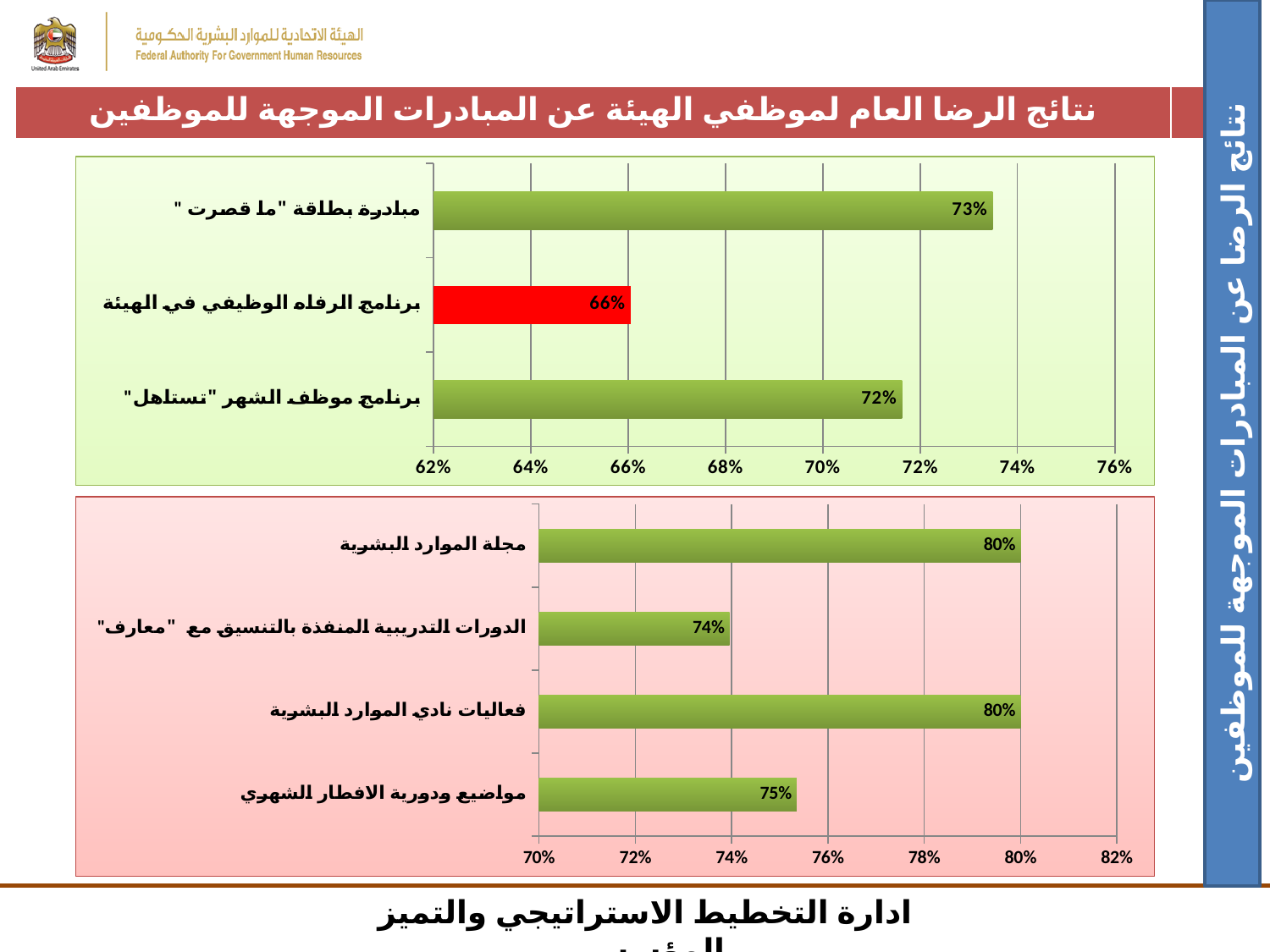
In the top chart, which bar is coloured red? برنامج الرفاه الوظيفي في الهيئة What type of chart is the bottom chart? Bar chart In the bottom chart, which category has the lowest value? الدورات التدريبية المنفذة بالتنسيق مع "معارف" In the bottom chart, what is the value for الدورات التدريبية المنفذة بالتنسيق مع "معارف"? 74% In the bottom chart, which is larger: مجلة الموارد البشرية or مواضيع ودورية الافطار الشهري? مجلة الموارد البشرية In the top chart, what is the value for برنامج الرفاه الوظيفي في الهيئة? 66% In the top chart, what is the value for مبادرة بطاقة "ما قصرت"? 73% In the top chart, what is the difference between مبادرة بطاقة "ما قصرت" and برنامج موظف الشهر "تستاهل"? 1% In the bottom chart, what is the value for مواضيع ودورية الافطار الشهري? 75% In the top chart, which category has the lowest value? برنامج الرفاه الوظيفي في الهيئة In the top chart, how many categories are shown? 3 In the bottom chart, how many categories are shown? 4